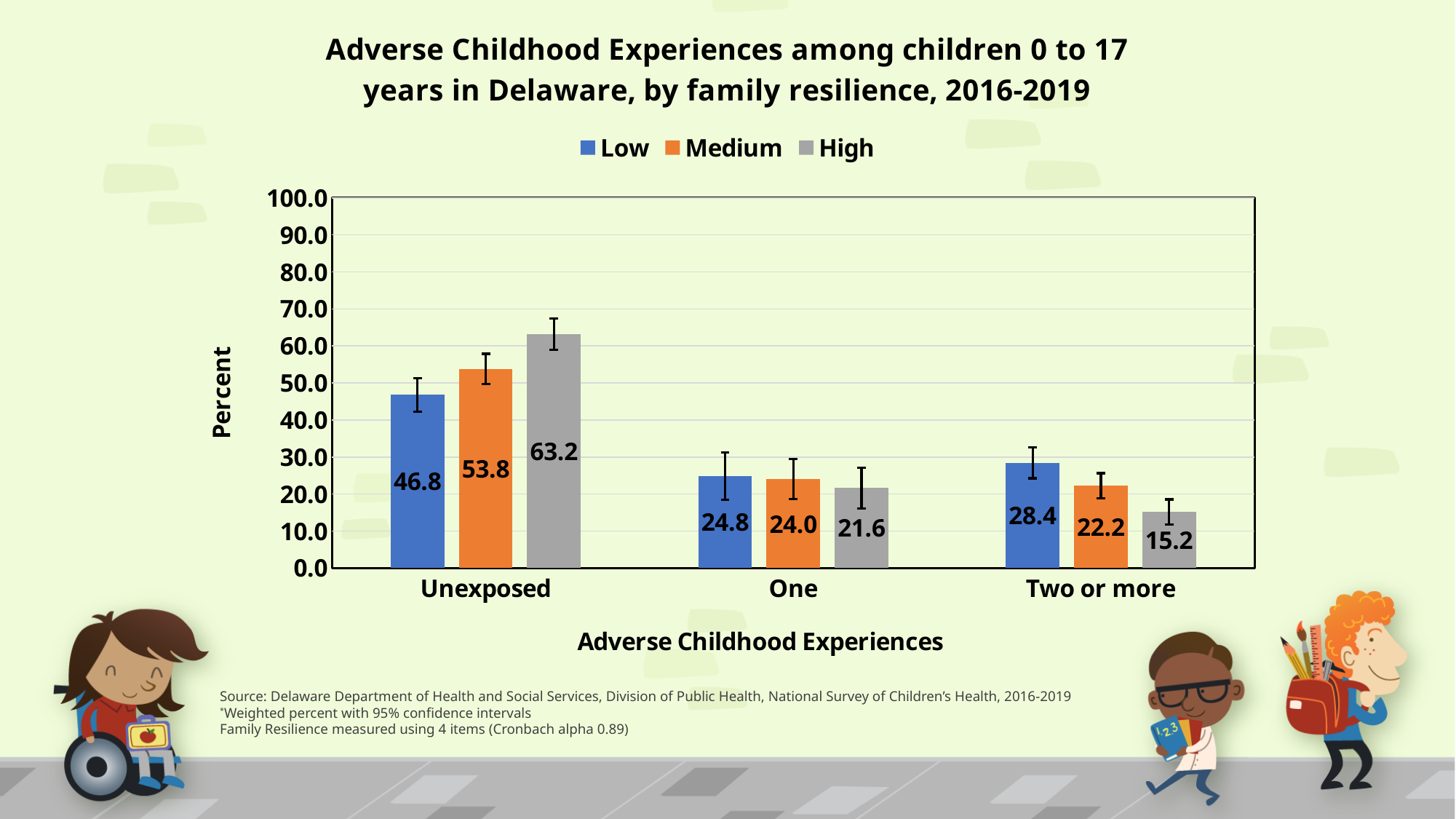
Which series has the highest value in the Unexposed category? High How many series does the legend list? 3 What kind of chart is shown on the slide? bar chart Which is larger: the Low value for One or the Low value for Two or more? Two or more Which series has the lowest value in the Two or more category? High Is the value for Medium in the Unexposed category greater or less than 50.0? greater What is the value for the Low series in the Two or more category? 28.4 How many categories are shown on the x axis? 3 What is the value for the High series in the Unexposed category? 63.2 What is the value for the Medium series in the One category? 24.0 What is the label of the y axis? Percent What is the difference between the High and Low values in the Unexposed category? 16.4